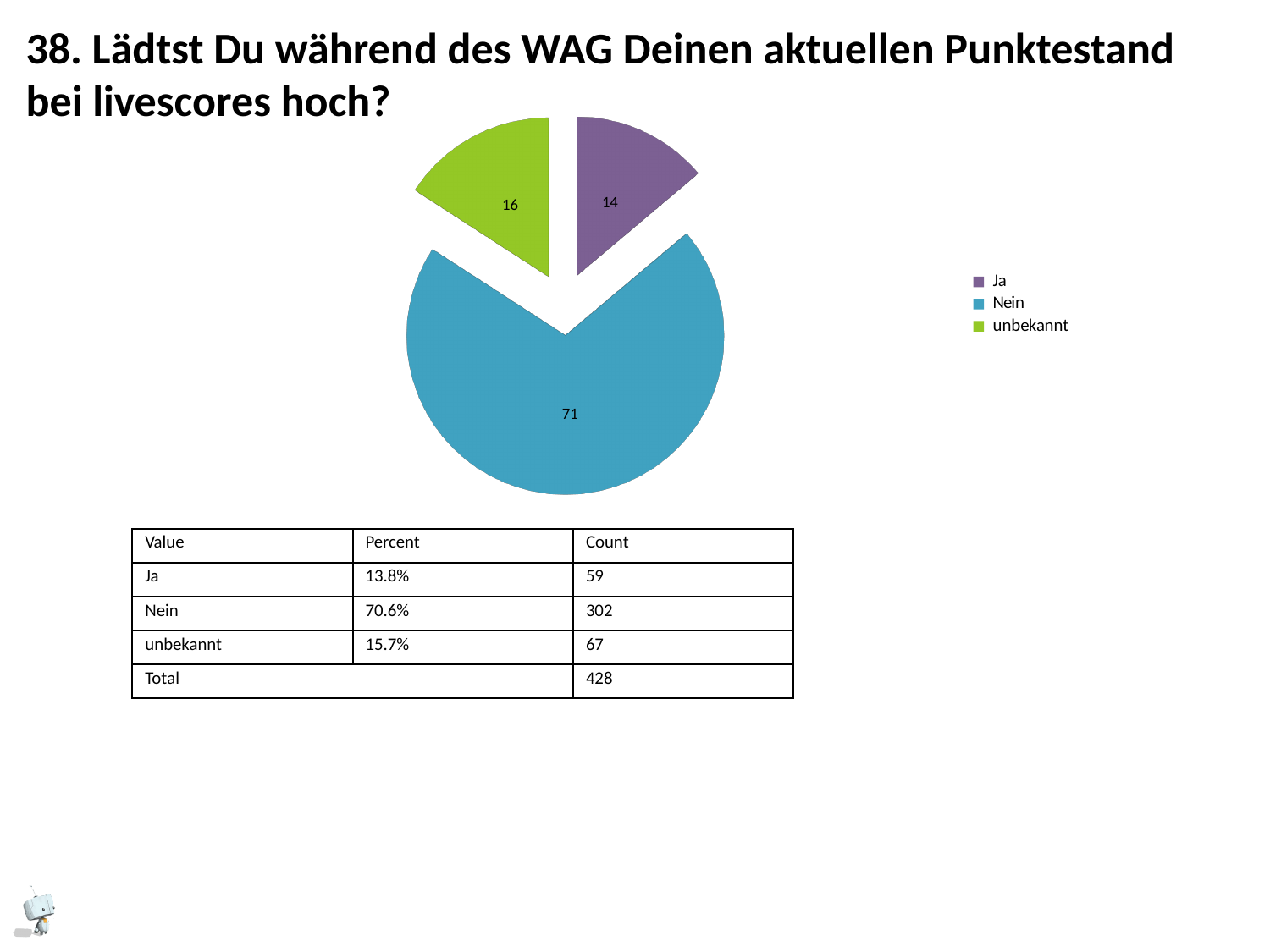
What is the difference between the data labels for unbekannt and Ja? 2 What is the data label on the pie slice for Nein? 71 How many entries does the legend list? 3 How many slices does the pie chart have? 3 Which slice is larger, Ja or Nein? Nein What is the difference between the data labels for Nein and unbekannt? 55 What colour is the Nein slice in the pie chart? blue What is the data label on the pie slice for unbekannt? 16 What type of chart is shown on the slide? pie chart Which category has the smallest slice of the pie? Ja What is the data label on the pie slice for Ja? 14 Which category has the largest slice of the pie? Nein